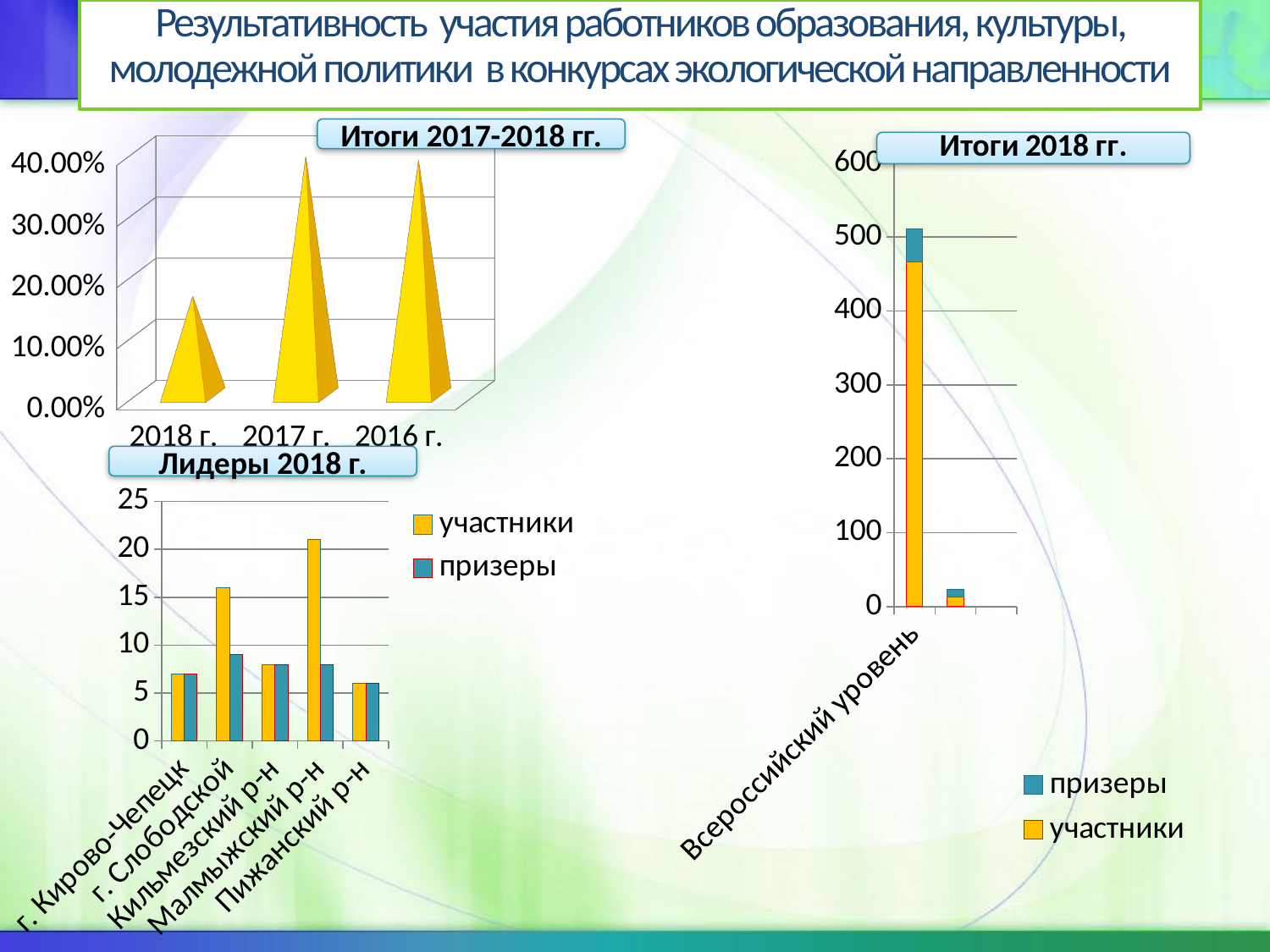
In the chart titled 'Лидеры 2018 г.', is the value of участники for Малмыжский р-н greater or less than 20? greater In the chart titled 'Лидеры 2018 г.', which is larger for г. Слободской: участники or призеры? участники In the chart titled 'Итоги 2018 гг.', is the value of участники for Всероссийский уровень greater or less than 400? greater In the chart titled 'Лидеры 2018 г.', which category has the highest value for участники? Малмыжский р-н In the chart titled 'Лидеры 2018 г.', is the value of участники for г. Кирово-Чепецк greater or less than 10? less How many categories are shown on the x axis of the chart titled 'Лидеры 2018 г.'? 5 What kind of chart is the chart titled 'Лидеры 2018 г.'? bar chart How many series does the legend of the chart titled 'Лидеры 2018 г.' list? 2 In the chart titled 'Итоги 2017-2018 гг.', which year has the lowest value? 2018 г. How many categories are shown on the x axis of the chart titled 'Итоги 2017-2018 гг.'? 3